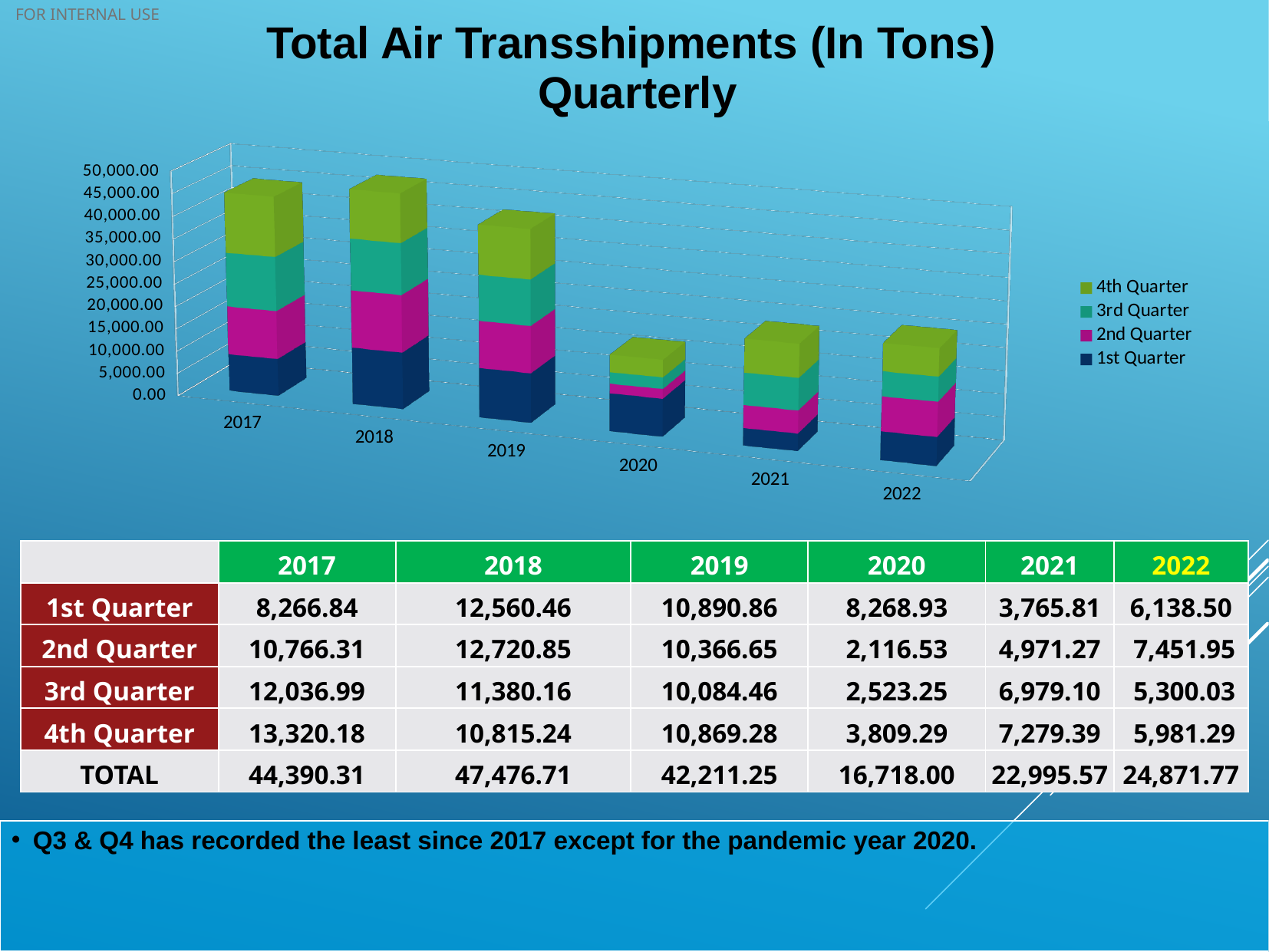
Is the total stacked bar for 2020 greater or less than 20,000.00? less How many years are plotted along the x axis of the chart? 6 What is the difference between the 2018 total and the 2017 total? 3,086.40 Which year has the highest total air transshipments? 2018 Which year has the lowest total air transshipments? 2020 What is the total of the stacked bar for 2019? 42,211.25 Do the total air transshipments rise or fall from 2018 to 2020? fall What kind of chart is shown on the slide? Stacked bar chart How many series does the chart legend list? 4 Which year has the larger total, 2021 or 2022? 2022 What is the 1st Quarter value for 2017? 8,266.84 What is the 4th Quarter value for 2020? 3,809.29